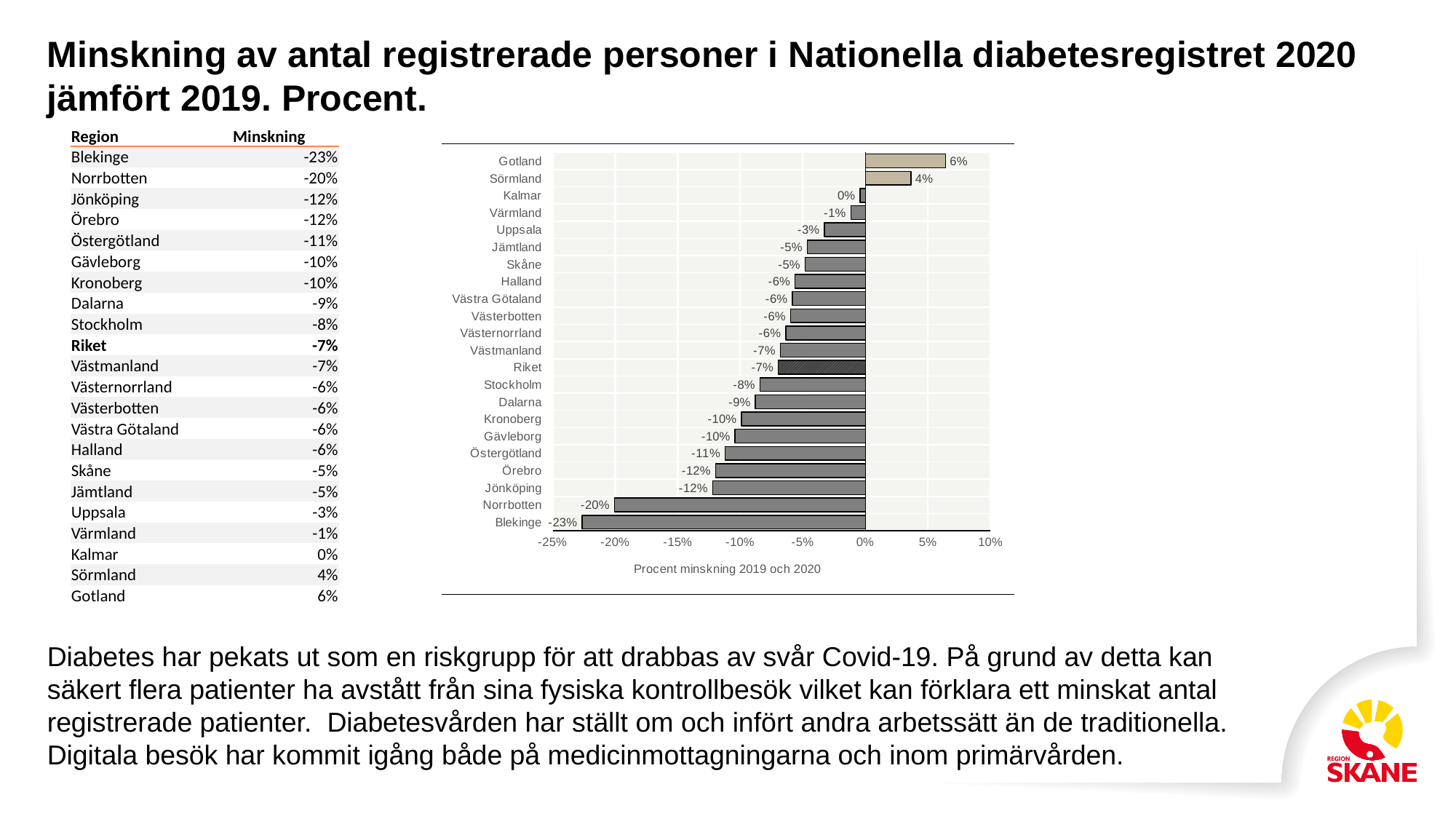
What value is shown for Riket in the bar chart? -7% Which region has the highest value in the bar chart? Gotland What is the label shown below the x axis of the chart? Procent minskning 2019 och 2020 What value is shown for Blekinge in the bar chart? -23% What is the difference in percentage points between the values for Norrbotten and Blekinge? 3 percentage points How many bars are plotted in the chart? 22 Which has the larger value, Stockholm or Dalarna? Stockholm What value is shown for Skåne in the bar chart? -5% What kind of chart is shown on the slide? Bar chart What is the difference in percentage points between the values for Gotland and Sörmland? 2 percentage points Which region has the lowest value in the bar chart? Blekinge What value is shown for Gotland in the bar chart? 6%